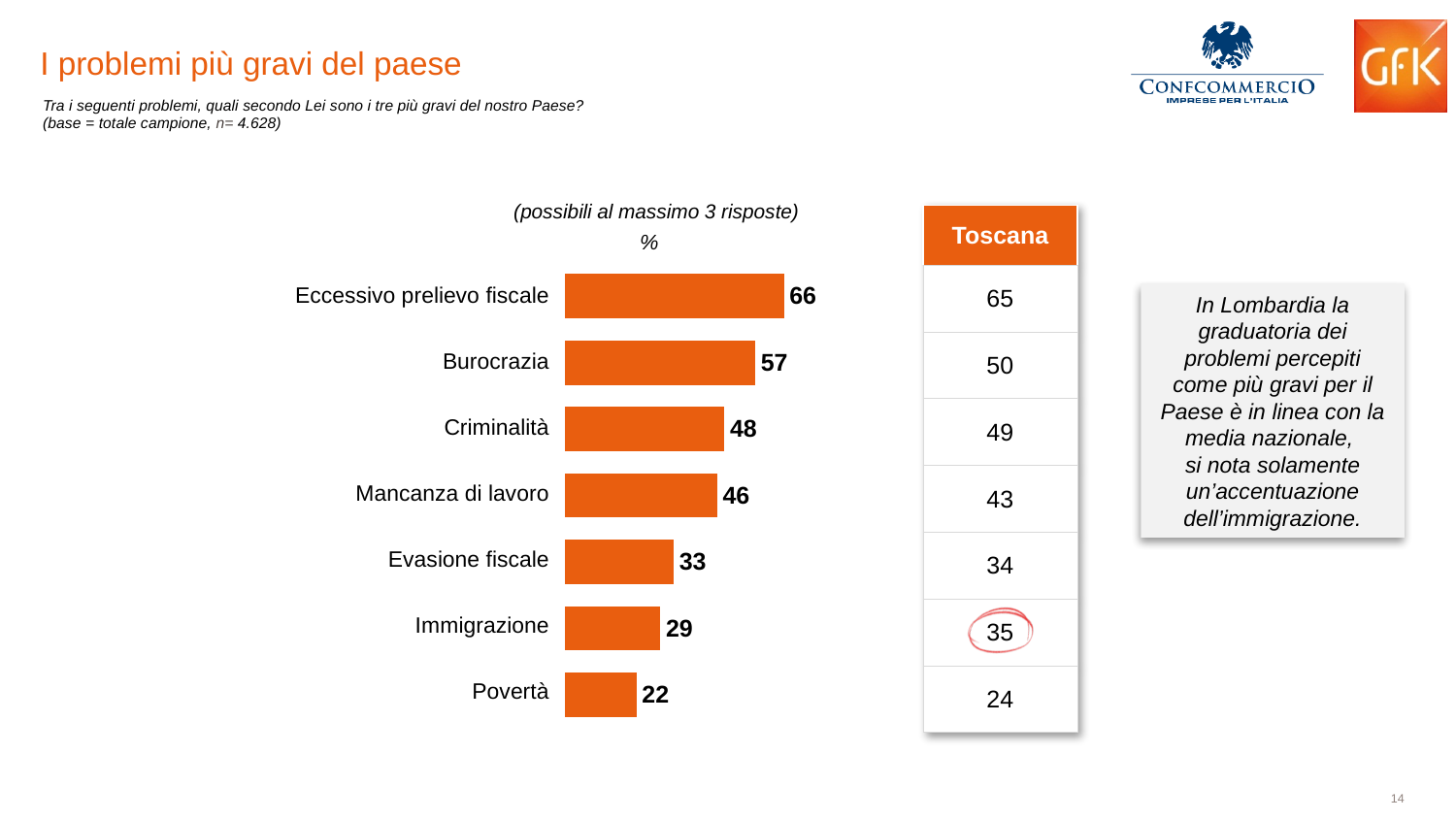
How many categories are shown in the bar chart? 7 Which has a larger value in the bar chart, Evasione fiscale or Immigrazione? Evasione fiscale What is the value for Burocrazia in the bar chart? 57 Which has a larger value in the bar chart, Criminalità or Mancanza di lavoro? Criminalità What is the difference between the values for Evasione fiscale and Povertà in the bar chart? 11 Which category has the lowest value in the bar chart? Povertà What is the value for Eccessivo prelievo fiscale in the bar chart? 66 What is the difference between the values for Burocrazia and Criminalità in the bar chart? 9 What kind of chart is shown on the slide? Bar chart What unit is indicated above the bars in the chart? % What is the value for Immigrazione in the bar chart? 29 Which category has the highest value in the bar chart? Eccessivo prelievo fiscale